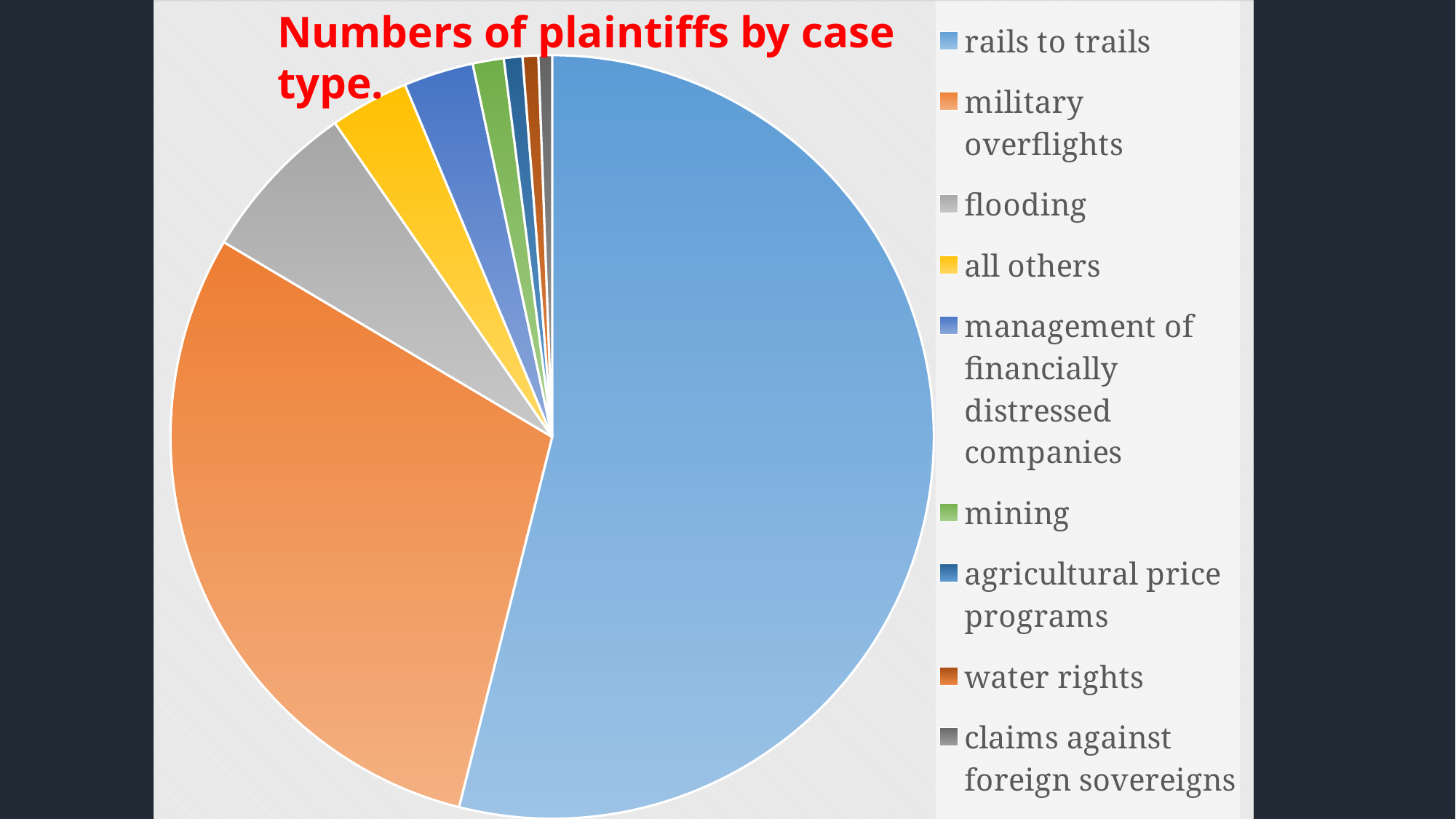
How many case types (slices) does the pie chart show? 9 Which case type has the second-largest slice of the pie? military overflights Which has more plaintiffs, rails to trails or military overflights? rails to trails What kind of chart is shown on the slide? pie chart Which has more plaintiffs, military overflights or flooding? military overflights Which has more plaintiffs, management of financially distressed companies or mining? management of financially distressed companies What is the title of the chart? Numbers of plaintiffs by case type. Which case type has the largest number of plaintiffs? rails to trails Does the rails to trails slice make up more or less than half of the pie? more